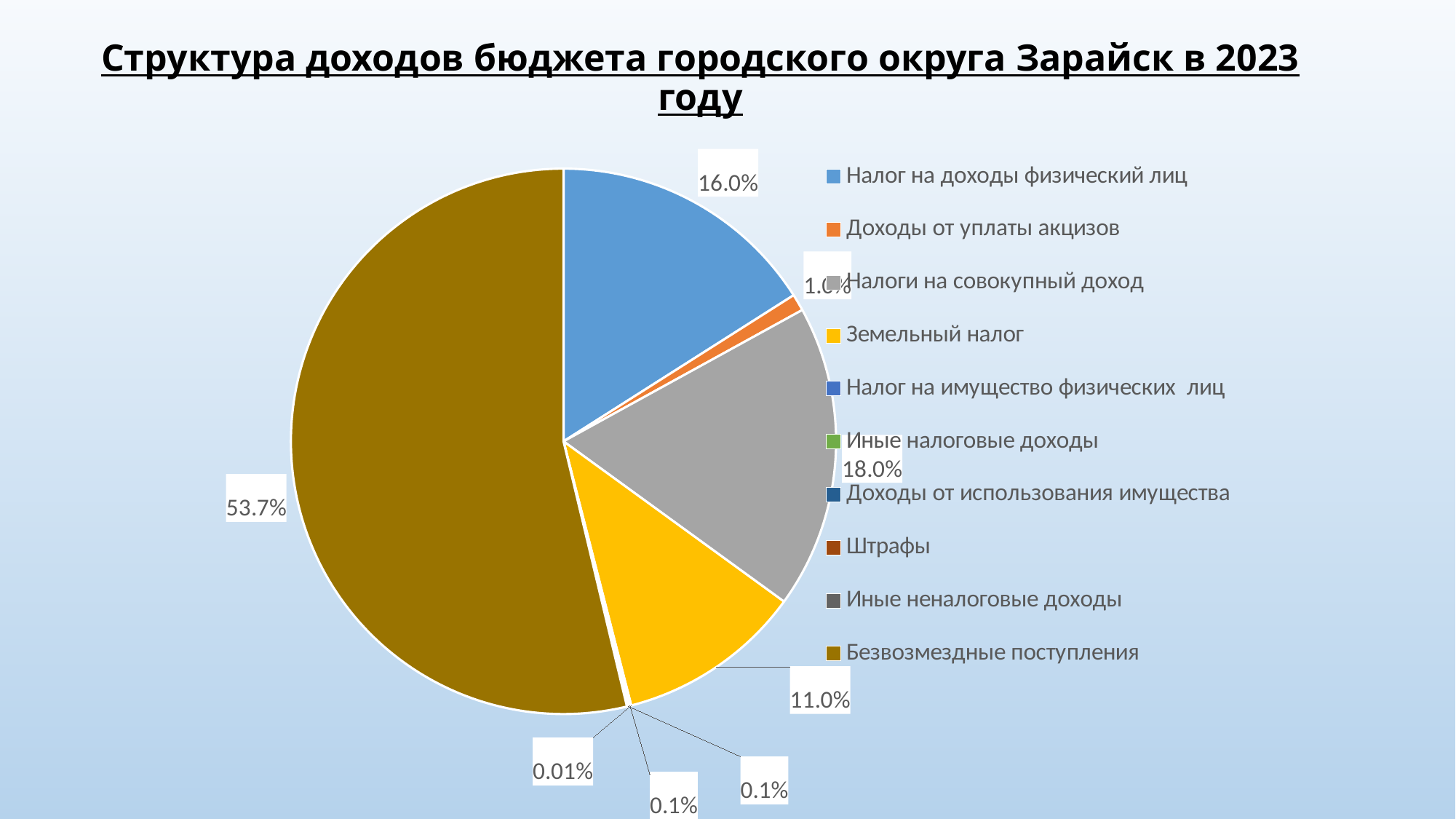
What share of the budget revenue is labelled for Безвозмездные поступления? 53.7% Which is larger: Налоги на совокупный доход or Налог на доходы физический лиц? Налоги на совокупный доход What is the title of the chart on the slide? Структура доходов бюджета городского округа Зарайск в 2023 году What is the difference in percentage points between Налоги на совокупный доход and Налог на доходы физический лиц? 2.0% What percentage is shown for Налог на доходы физический лиц? 16.0% What is the difference in percentage points between Безвозмездные поступления and Налоги на совокупный доход? 35.7% What type of chart is shown on the slide? Pie chart Which category has the largest slice of the pie? Безвозмездные поступления How many categories does the legend of the pie chart list? 10 Does Безвозмездные поступления account for more or less than half of the pie? More What percentage is shown for Налоги на совокупный доход? 18.0% What percentage is shown for Земельный налог? 11.0%